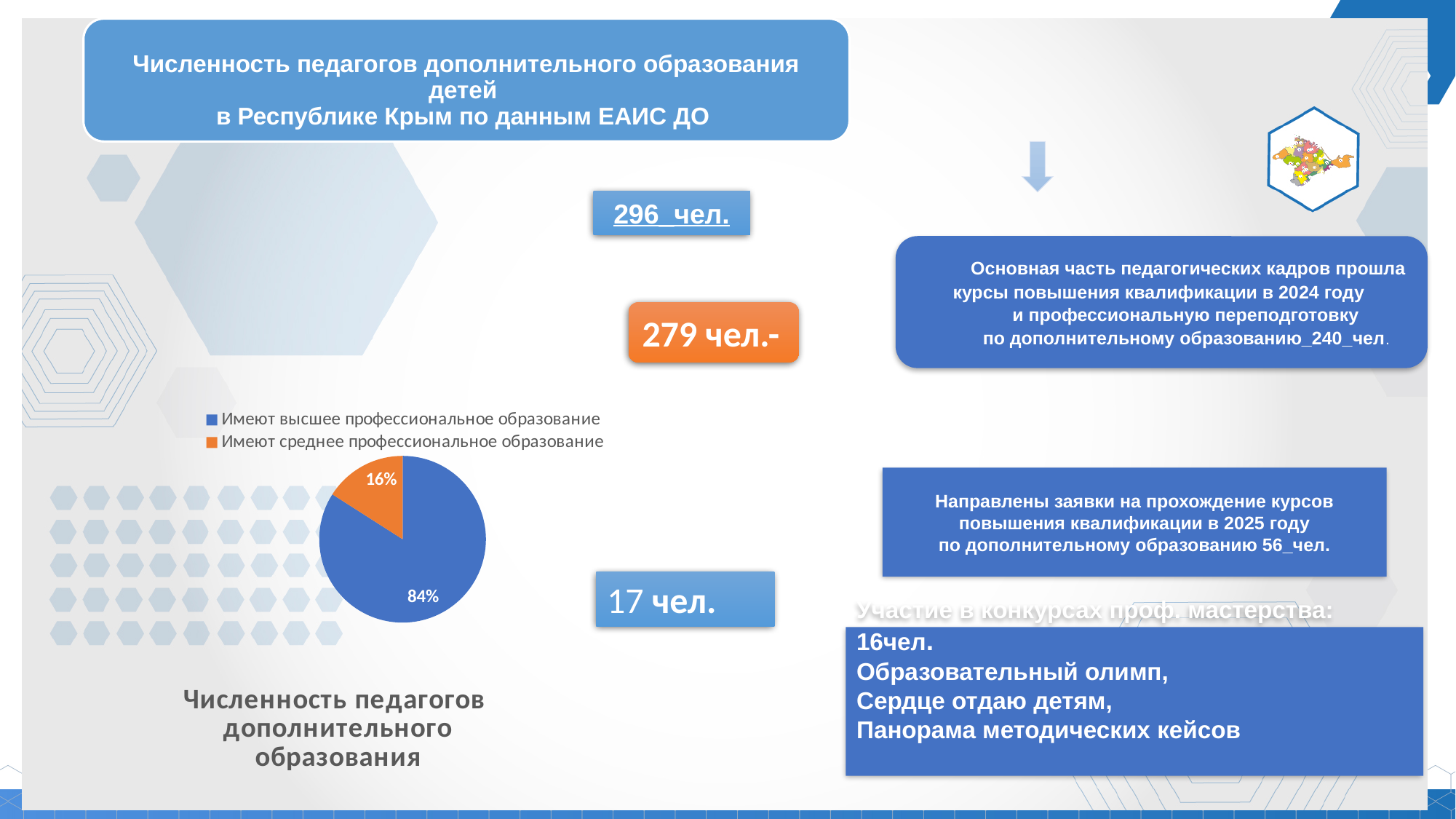
What is the title shown below the pie chart? Численность педагогов дополнительного образования How many entries does the legend of the pie chart list? 2 What is the difference in percentage points between the two slices of the pie chart? 68 How many slices does the pie chart have? 2 What colour is the slice for "Имеют среднее профессиональное образование" in the pie chart? orange Which is larger in the pie chart: the share with higher professional education or the share with secondary professional education? Имеют высшее профессиональное образование What share of the pie chart is labelled "Имеют высшее профессиональное образование"? 84% Which slice of the pie chart is the largest? Имеют высшее профессиональное образование What share of the pie chart is labelled "Имеют среднее профессиональное образование"? 16% What kind of chart is shown on the slide? pie chart Which slice of the pie chart is the smallest? Имеют среднее профессиональное образование